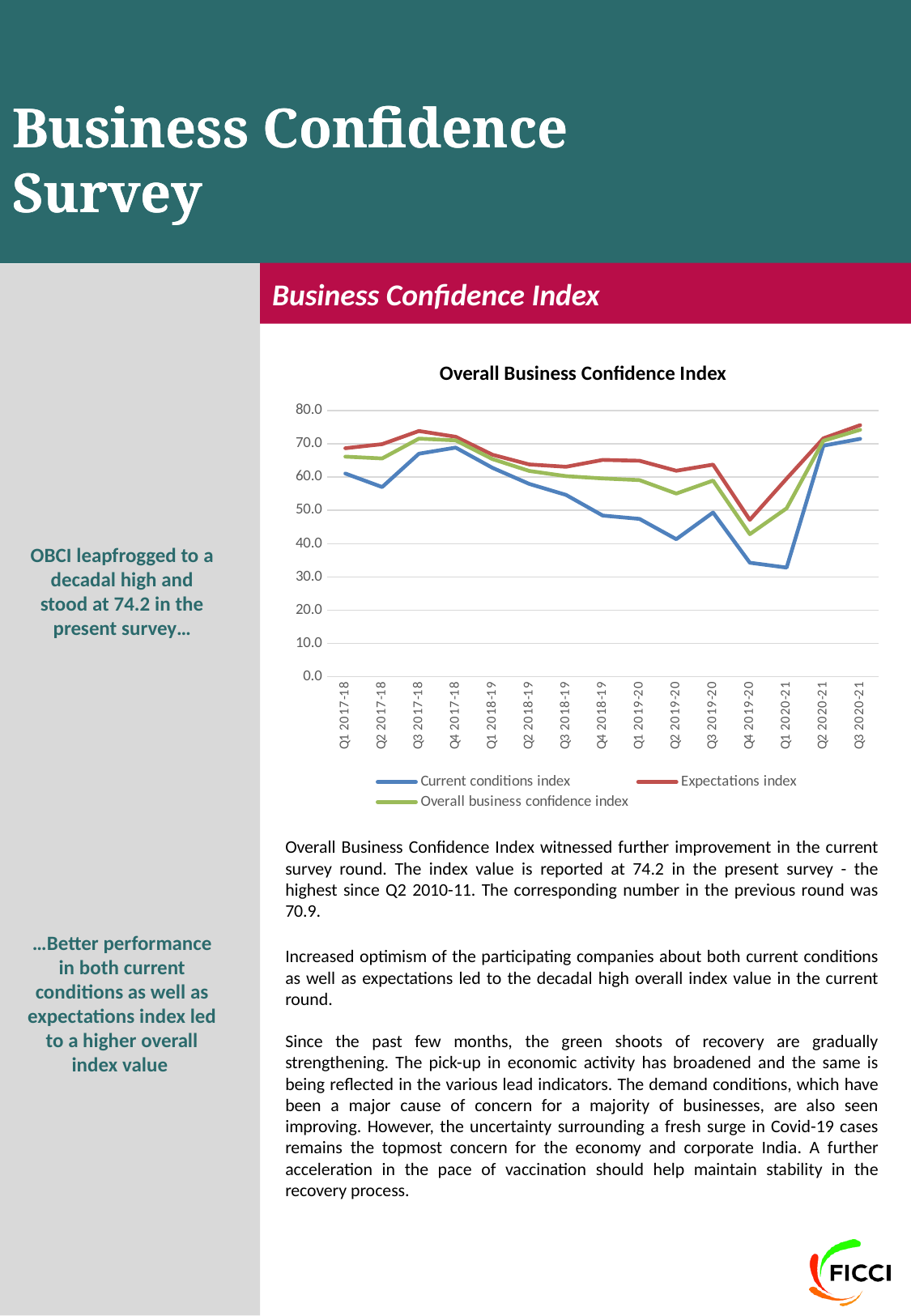
What kind of chart is shown on the slide? Line chart Is the value of the Overall business confidence index in Q4 2019-20 greater or less than 50.0? less What is the title of the chart? Overall Business Confidence Index In which quarter does the Current conditions index reach its lowest point? Q1 2020-21 Is the value of the Expectations index in Q3 2017-18 greater or less than 70.0? greater In Q1 2020-21, which is higher: the Expectations index or the Current conditions index? Expectations index How many quarters are plotted along the x axis of the chart? 15 How many series does the chart legend list? 3 Is the value of the Current conditions index in Q1 2020-21 greater or less than 40.0? less Does the Current conditions index rise or fall between Q4 2017-18 and Q1 2020-21? Fall In which quarter does the Overall business confidence index reach its lowest point? Q4 2019-20 Which series is drawn in blue in the chart? Current conditions index